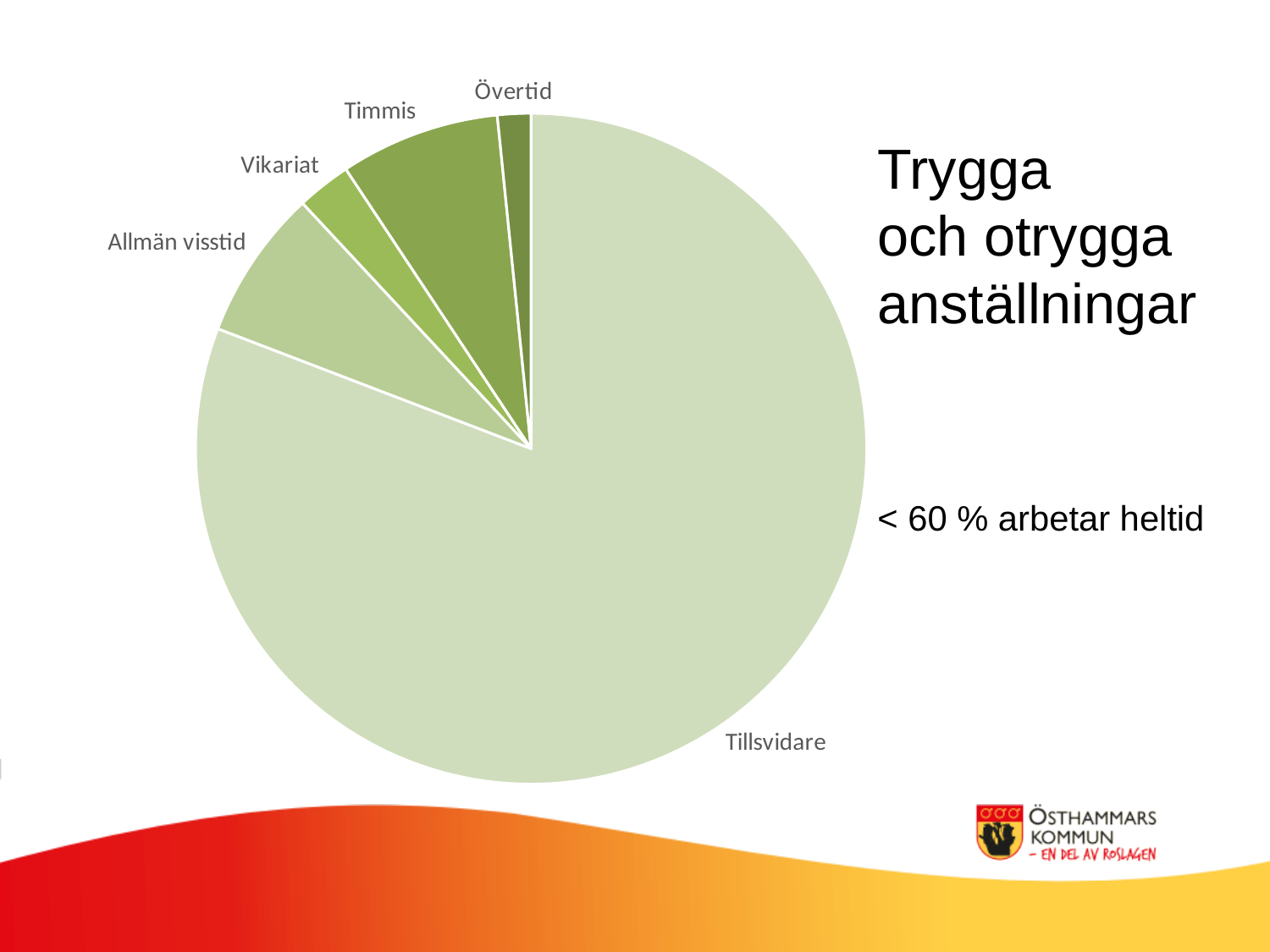
How many slices does the pie chart have? 5 Which slice label appears at the bottom right of the pie chart? Tillsvidare Which slice is larger, Timmis or Övertid? Timmis Does the Tillsvidare slice take up more or less than half of the pie? more Which category has the largest slice of the pie chart? Tillsvidare Which category has the smallest slice of the pie chart? Övertid What is the heading text shown to the right of the pie chart? Trygga och otrygga anställningar What kind of chart is shown on the slide? pie chart Which slice is larger, Vikariat or Övertid? Vikariat Which slice is larger, Allmän visstid or Vikariat? Allmän visstid